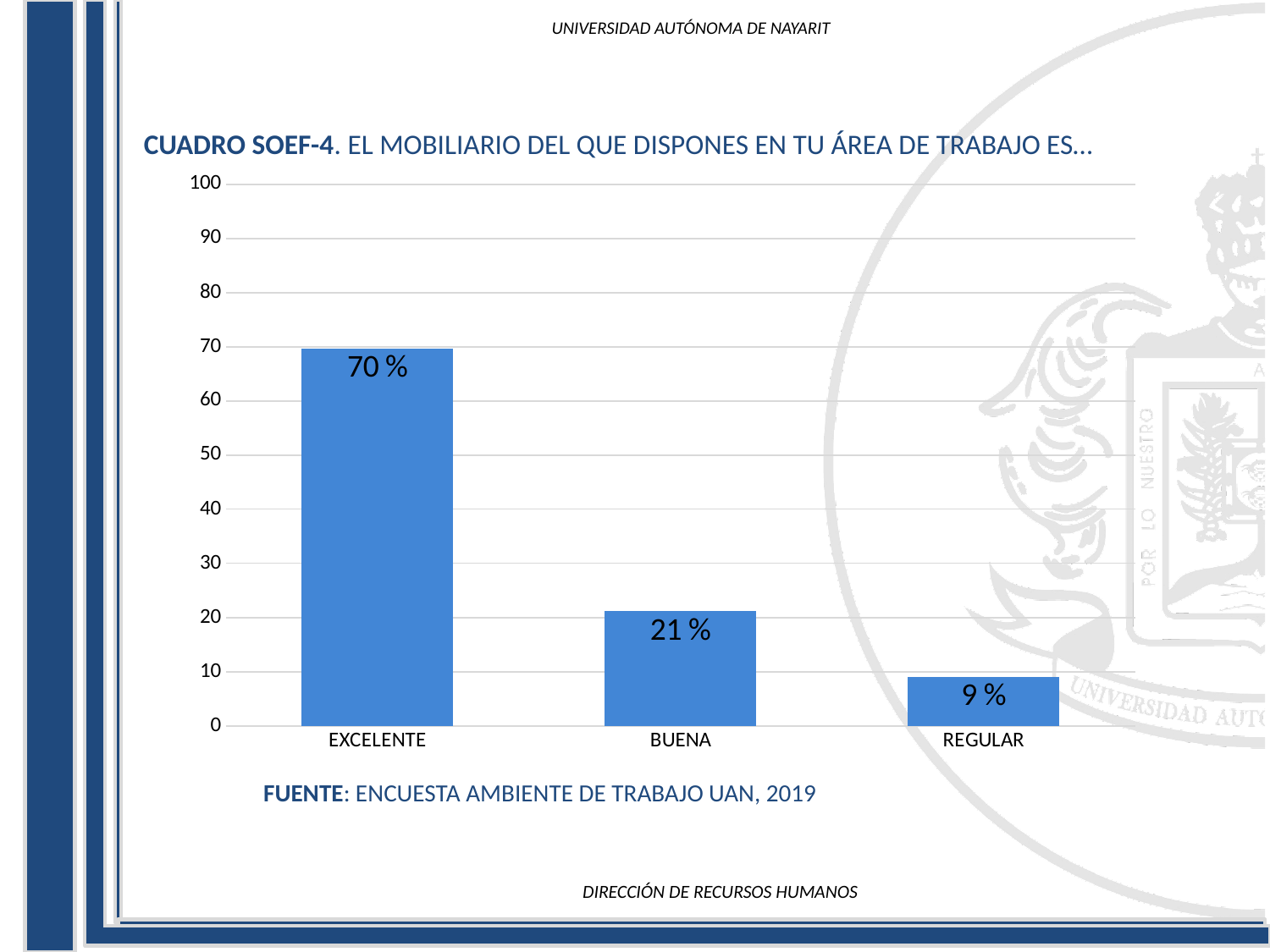
What kind of chart is shown on the slide? bar chart How many categories are shown on the x axis? 3 What is the value for REGULAR? 9 % What is the value for EXCELENTE? 70 % What is the difference between the values for BUENA and REGULAR? 12 % Which category has the highest value? EXCELENTE Which category has the lowest value? REGULAR Do the values rise or fall from left to right along the x axis? fall What is the difference between the values for EXCELENTE and BUENA? 49 % What is the value for BUENA? 21 % Which is larger, the value for BUENA or the value for REGULAR? BUENA Is the value for BUENA greater or less than 30? less